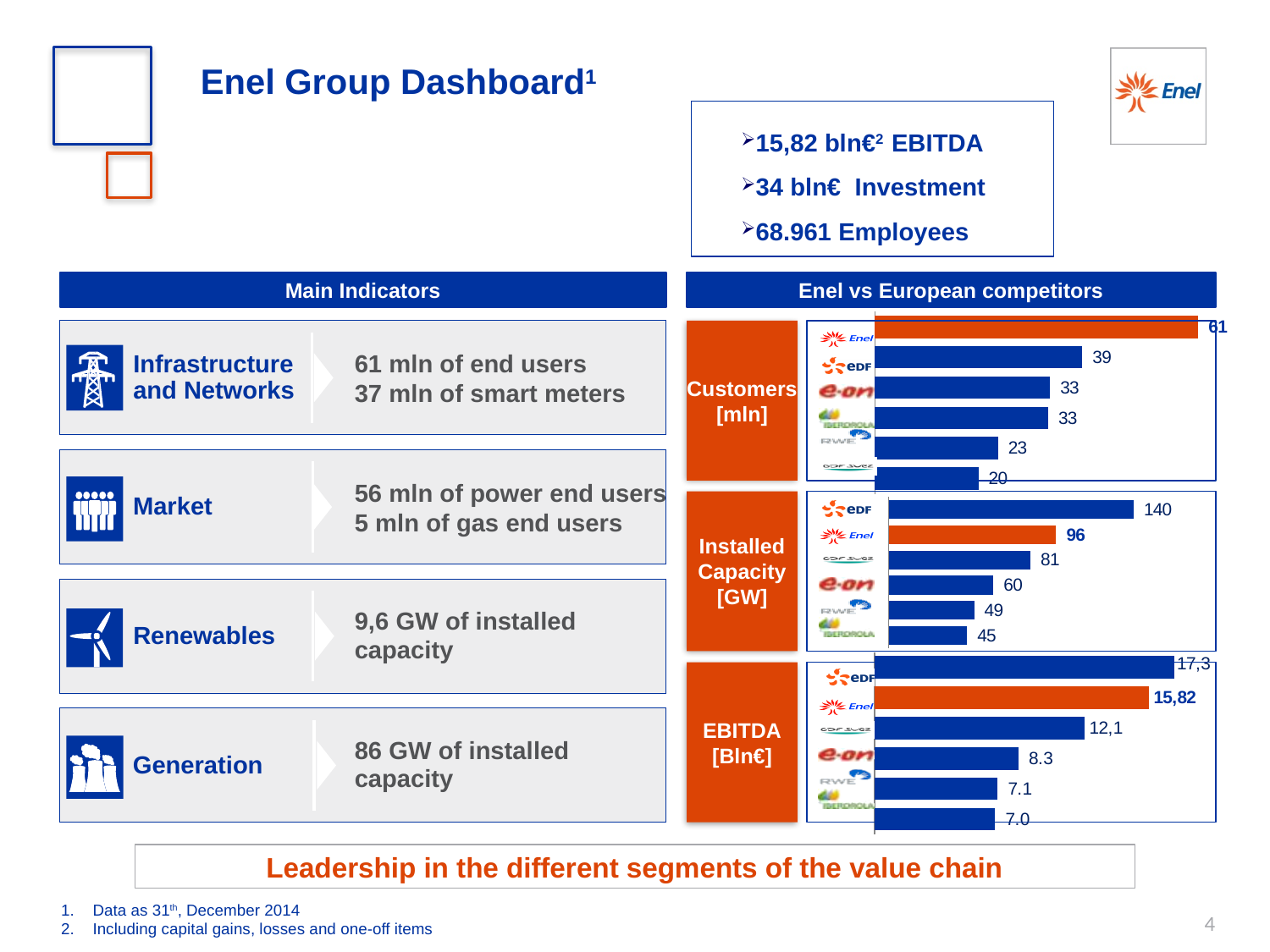
How many companies are shown in the EBITDA [Bln€] chart? 6 In the EBITDA [Bln€] chart, what is the value for Enel? 15,82 In the Customers [mln] chart, what is the difference between Enel and EDF? 22 In the Installed Capacity [GW] chart, what is the value for Enel? 96 In the Installed Capacity [GW] chart, which company has the highest value? EDF In the EBITDA [Bln€] chart, which is larger, the value for E.ON or the value for RWE? E.ON In the Customers [mln] chart, what is the value for Enel? 61 In the Customers [mln] chart, which company has the highest value? Enel In the Customers [mln] chart, what is the value for EDF? 39 In the Installed Capacity [GW] chart, which company has the lowest value? Iberdrola What type of chart is the Installed Capacity [GW] chart? Bar chart In the Installed Capacity [GW] chart, what is the difference between EDF and Enel? 44